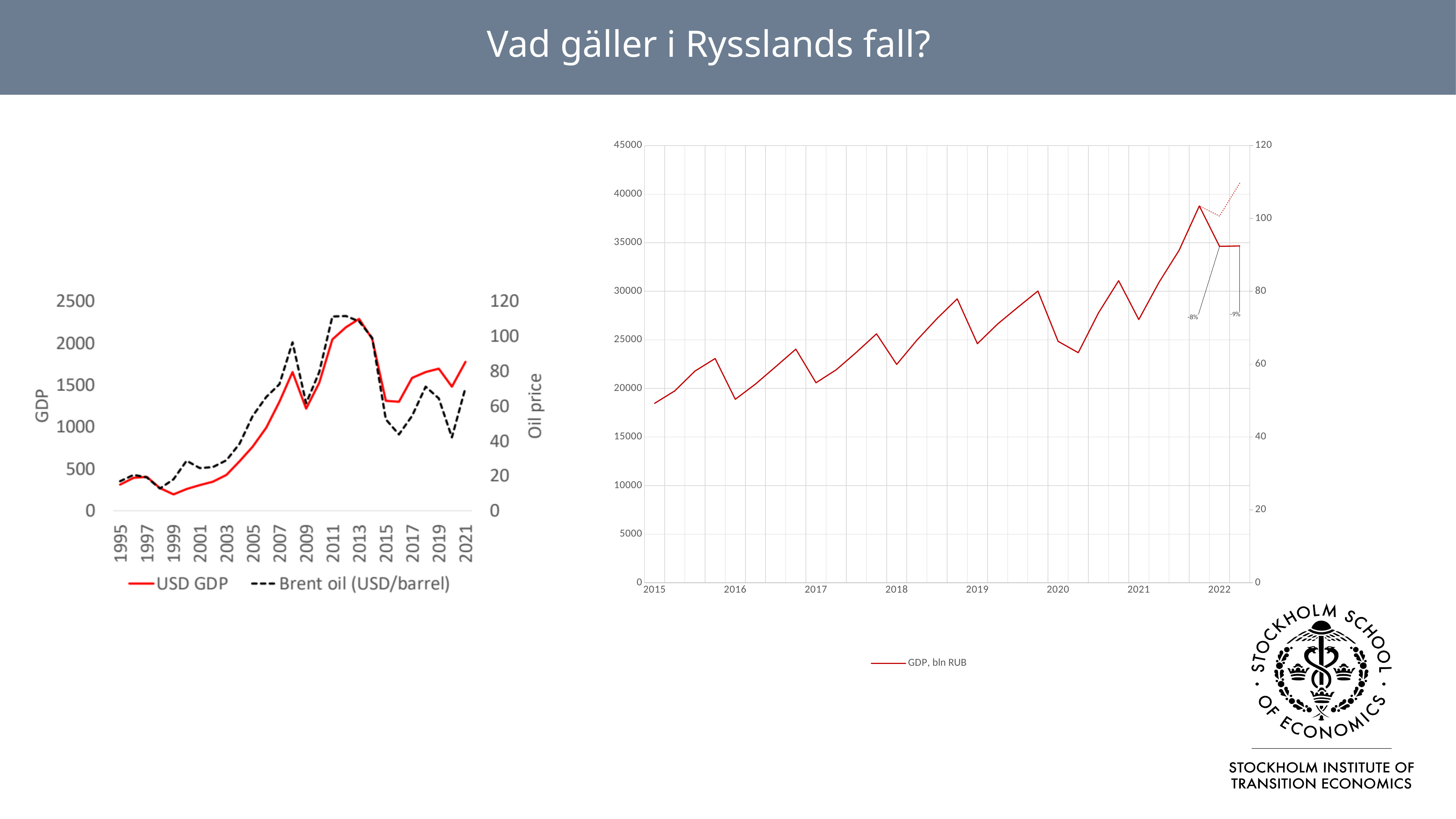
What two percentage labels are printed near the end of the line in the right chart? -8% and -9% In the left chart, is the USD GDP value for 1999 greater or less than 500? less In the left chart, is the Brent oil price for 1999 greater or less than 20? less What kind of chart is the right chart (GDP, bln RUB)? line chart In the left chart, in which year does USD GDP reach its highest value? 2013 In the right chart, is the GDP value at the start of 2015 greater or less than 20000? less In the left chart, does USD GDP overall rise or fall from 1995 to 2021? rise How many series does the legend of the left chart list? 2 What kind of chart is the left chart (USD GDP and Brent oil)? line chart How many series does the legend of the right chart list? 1